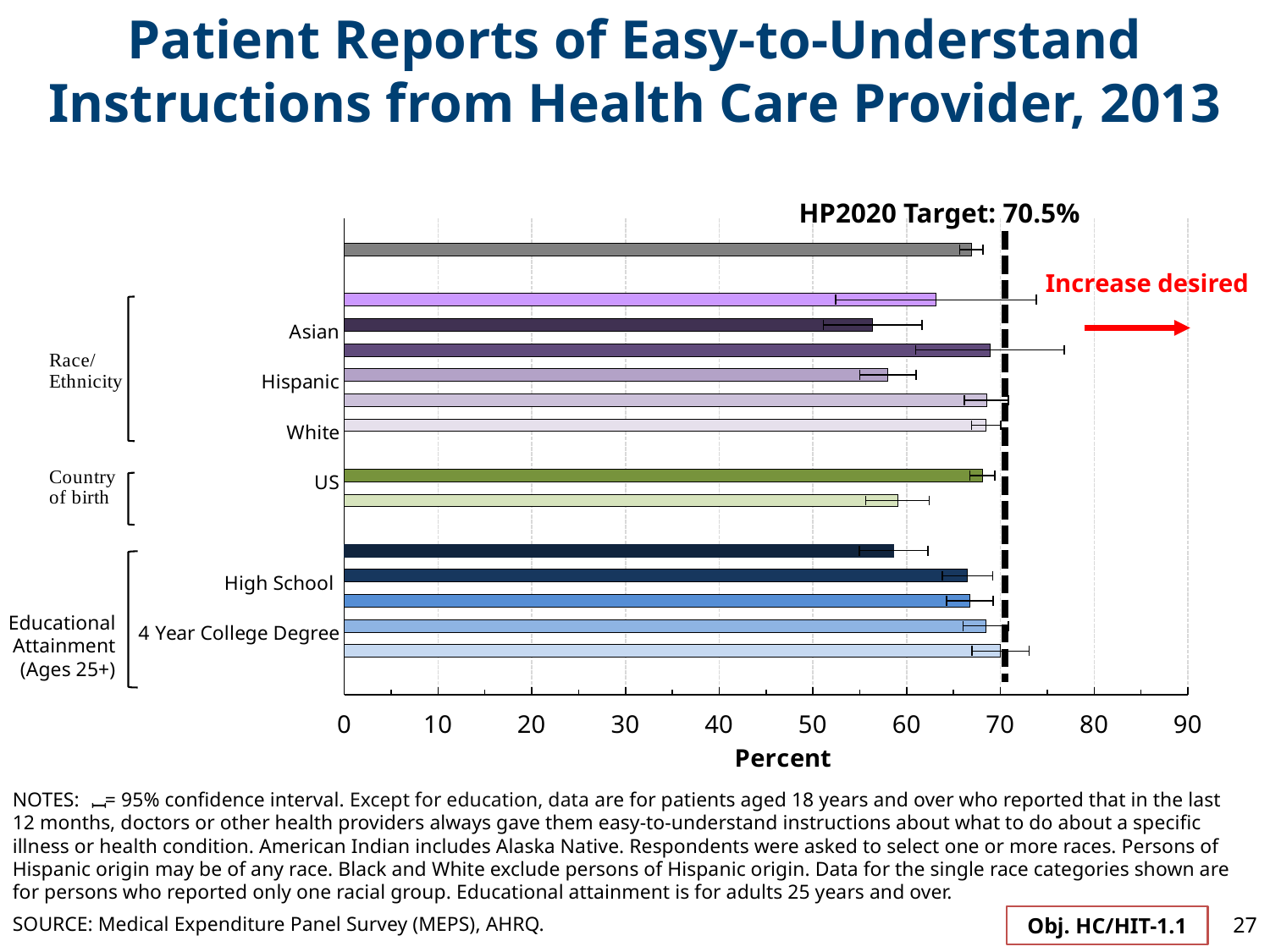
Is the value for Hispanic greater or less than 70? less Which is larger, the value for High School or the value for Asian? High School Is the value for Asian greater or less than 60? less Is the value for 4 Year College Degree greater or less than 70? less Which is larger, the value for White or the value for Asian? White Which is larger, the value for US or the value for Hispanic? US What is the label of the horizontal axis? Percent What kind of chart is shown on the slide? bar chart What is the HP2020 Target value shown on the chart? 70.5%